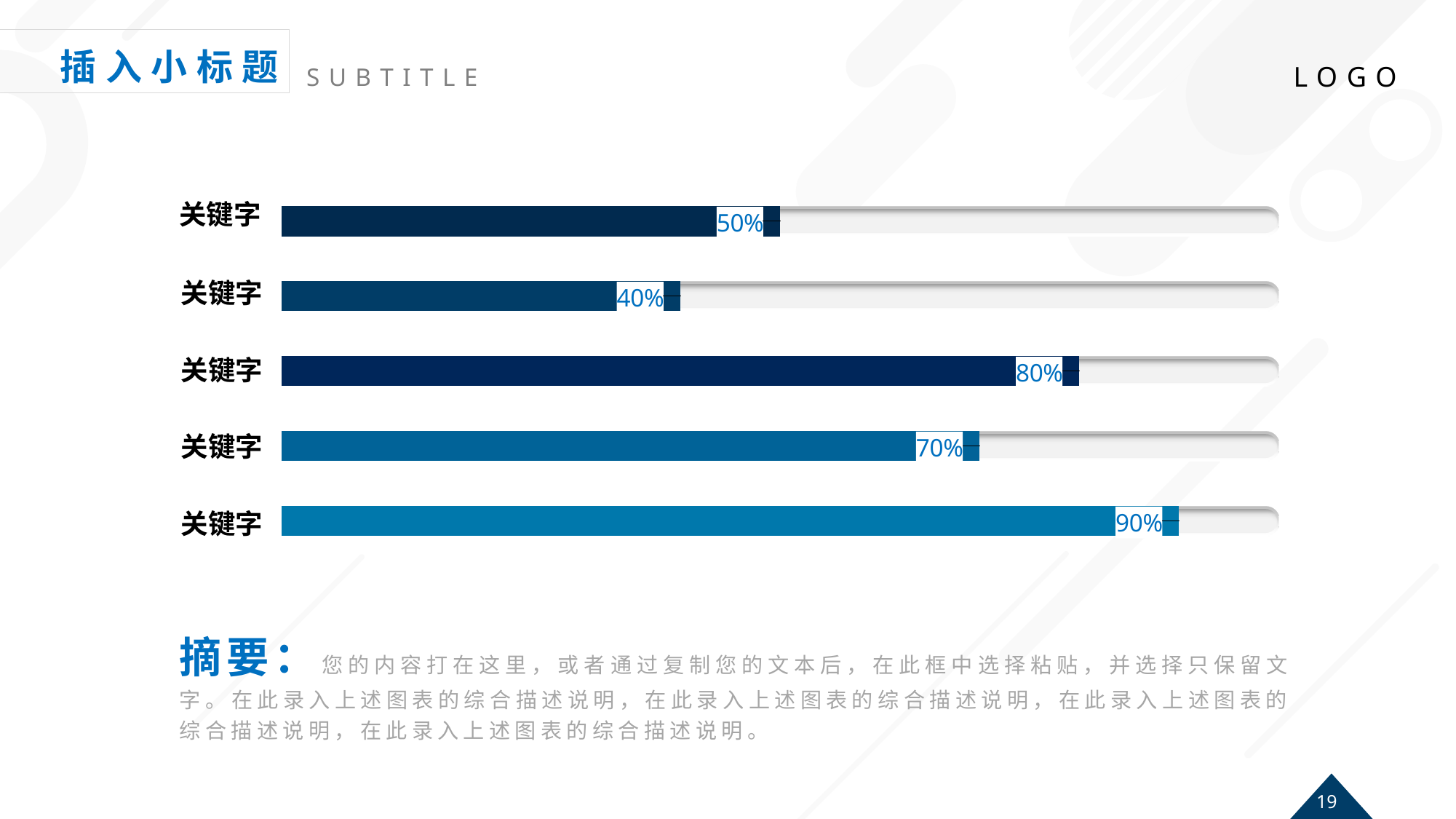
What is the value of the top (first) bar? 50% How many bars does the chart have? 5 What is the value of the bottom (fifth) bar? 90% What is the value of the fourth bar from the top? 70% Which bar has the highest value? the bottom bar (90%) What is the difference between the bottom bar's value and the top bar's value? 40% What label is shown next to each bar in the chart? 关键字 What is the value of the third bar from the top? 80% What is the value of the second bar from the top? 40% What kind of chart is shown on the slide? bar chart Which is larger, the value of the third bar (80%) or the fourth bar (70%)? the third bar (80%) Which bar has the lowest value? the second bar from the top (40%)